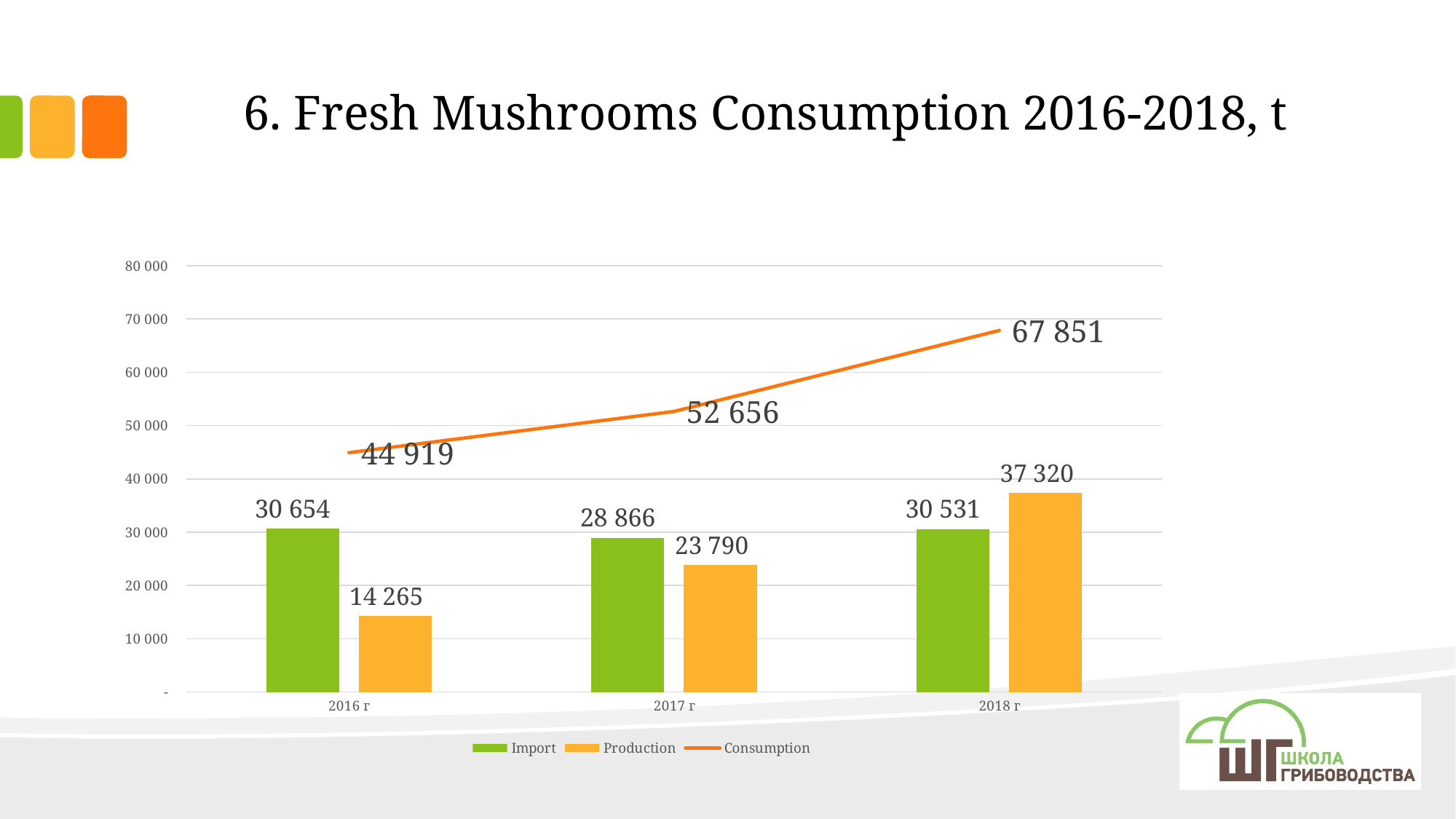
By how much did Consumption increase from 2017 г to 2018 г? 15 195 Does Consumption rise or fall from 2016 г to 2018 г? Rise How many series does the legend list? 3 In which year is Production lowest? 2016 г What is the Production value for 2018 г? 37 320 How many years are shown on the x axis? 3 Which is larger in 2018 г, Import or Production? Production What kind of chart is this? Combination bar and line chart In which year is Consumption highest? 2018 г What is the Import value for 2017 г? 28 866 What is the Consumption value for 2016 г? 44 919 What is the difference between Production in 2018 г and Production in 2016 г? 23 055